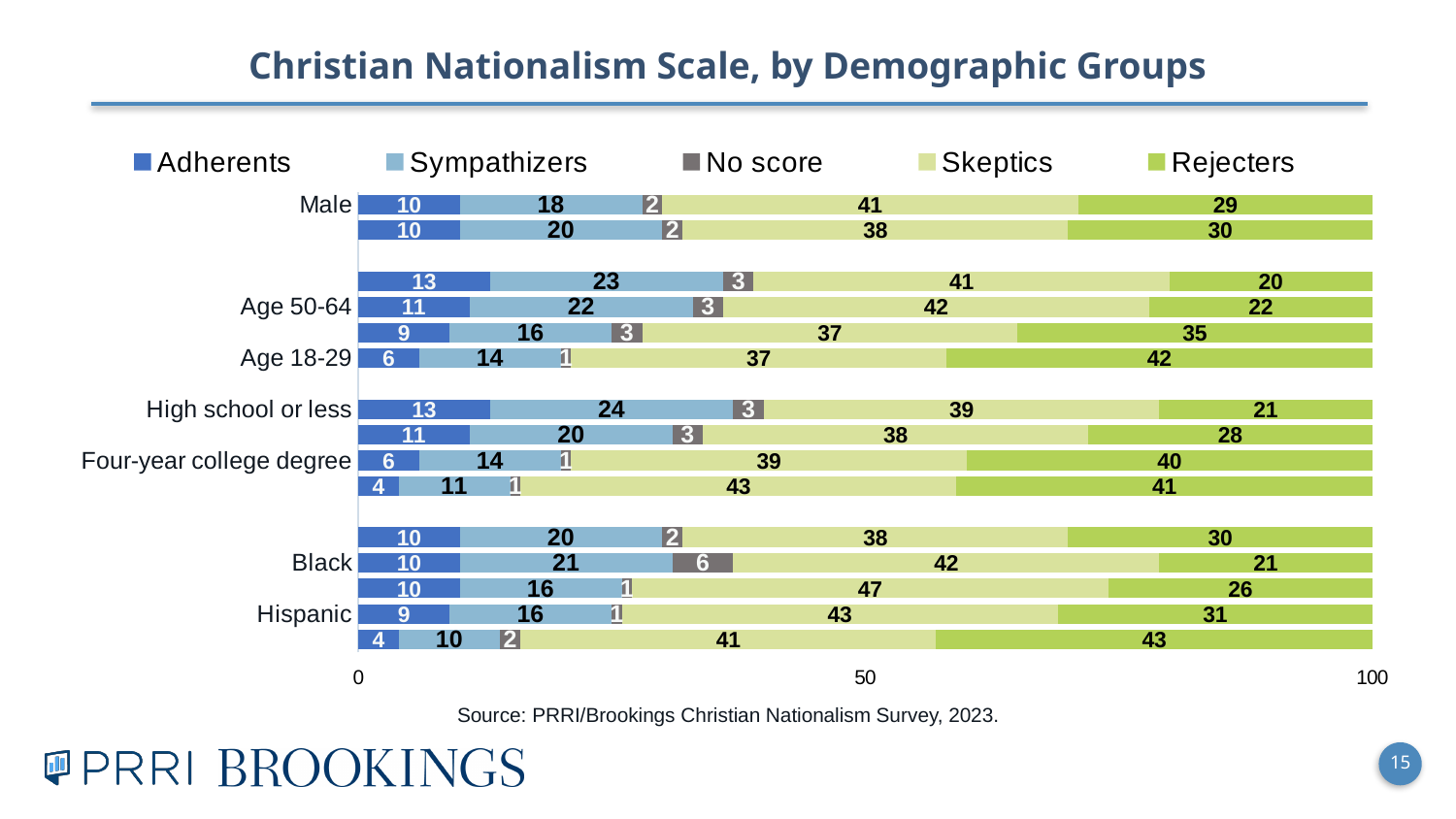
Which has a higher Adherents value, High school or less or Four-year college degree? High school or less What is the No score value for Black? 6 What is the total of the stacked bar for Male? 100 How many series does the legend list? 5 What is the difference between the Rejecters values for Age 18-29 and Age 50-64? 20 Which has a higher Rejecters value, Black or Hispanic? Hispanic What is the Sympathizers value for High school or less? 24 What is the Rejecters value for Age 18-29? 42 What kind of chart is shown on the slide? Stacked bar chart What is the title of the chart? Christian Nationalism Scale, by Demographic Groups What is the Skeptics value for Hispanic? 43 What is the Adherents value for Male? 10